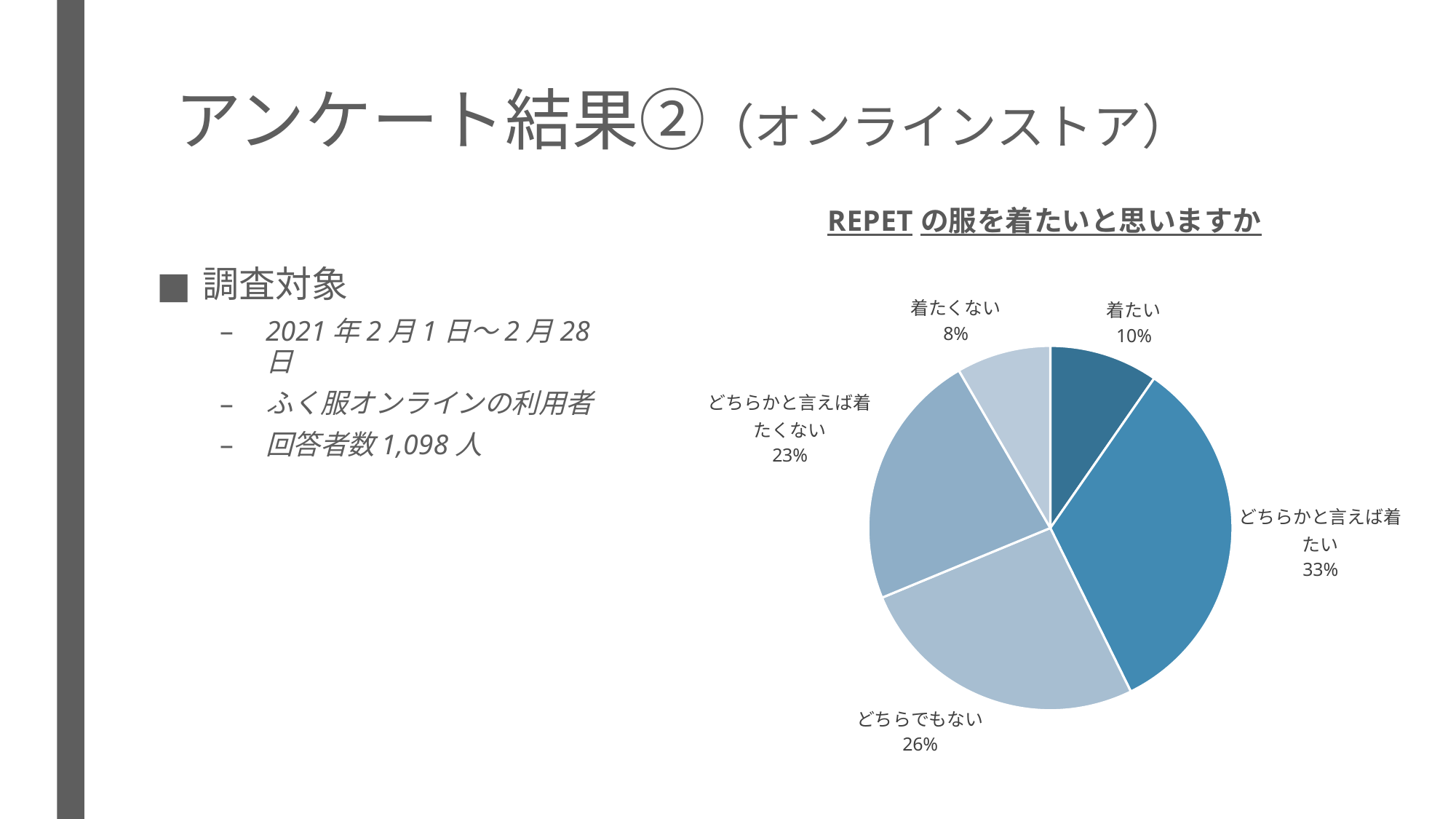
What kind of chart is shown on the slide? pie chart Which slice of the pie is the largest? どちらかと言えば着たい What share of the pie is labelled どちらかと言えば着たくない? 23% What share of the pie is labelled どちらでもない? 26% What is the title of the pie chart? REPET の服を着たいと思いますか How many slices does the pie chart have? 5 What share of the pie is labelled 着たい? 10% What share of the pie is labelled どちらかと言えば着たい? 33% What share of the pie is labelled 着たくない? 8% What is the difference between the shares for どちらかと言えば着たい and どちらでもない? 7% Which is larger, the share for 着たい or the share for 着たくない? 着たい Which slice of the pie is the smallest? 着たくない